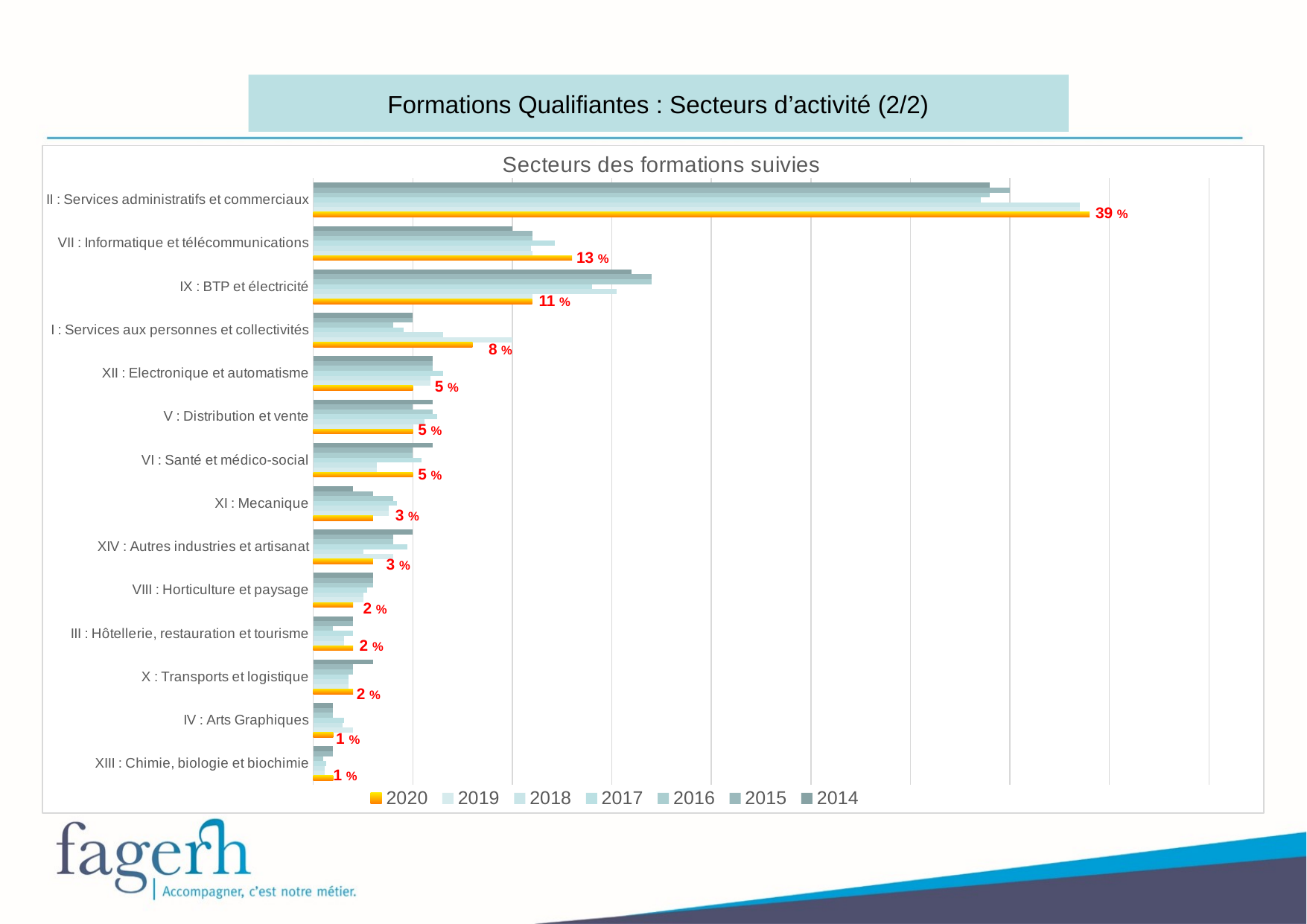
How many sectors are listed on the chart? 14 Which has the larger 2020 value, VII : Informatique et télécommunications or IX : BTP et électricité? VII : Informatique et télécommunications What is the title of the chart? Secteurs des formations suivies What kind of chart is shown? Bar chart How many series does the legend list? 7 What is the 2020 value for XI : Mecanique? 3 % What is the 2020 value for I : Services aux personnes et collectivités? 8 % Which sector has the highest 2020 value? II : Services administratifs et commerciaux What is the difference between the 2020 values for II : Services administratifs et commerciaux and VII : Informatique et télécommunications? 26 % What is the 2020 value for II : Services administratifs et commerciaux? 39 % What is the 2020 value for VII : Informatique et télécommunications? 13 % What is the 2020 value for IX : BTP et électricité? 11 %